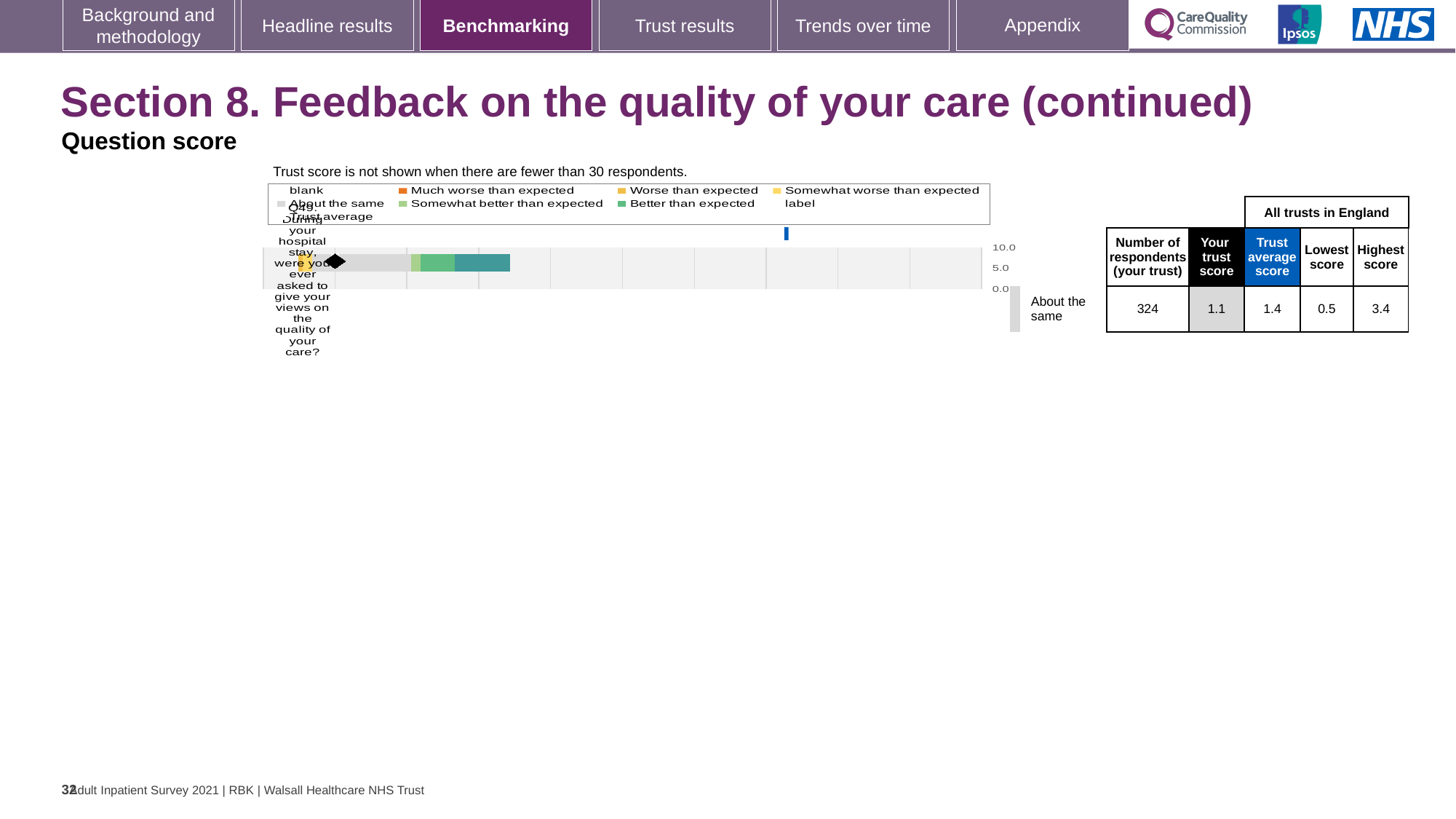
Which question number is plotted in the chart? Q49 How many survey questions are plotted in the chart? 1 What is the lowest score across all trusts in England for Q49? 0.5 What is the 'Trust average score' for Q49? 1.4 What benchmark rating is shown for Q49 next to the chart? About the same What kind of chart is shown on the slide? bar chart What is the 'Your trust score' value for Q49? 1.1 Which is larger for Q49, your trust score or the trust average score? Trust average score How many respondents from your trust answered Q49? 324 What is the difference between the trust average score and your trust score for Q49? 0.3 What is the highest score across all trusts in England for Q49? 3.4 What is the difference between the highest score and the lowest score for Q49? 2.9